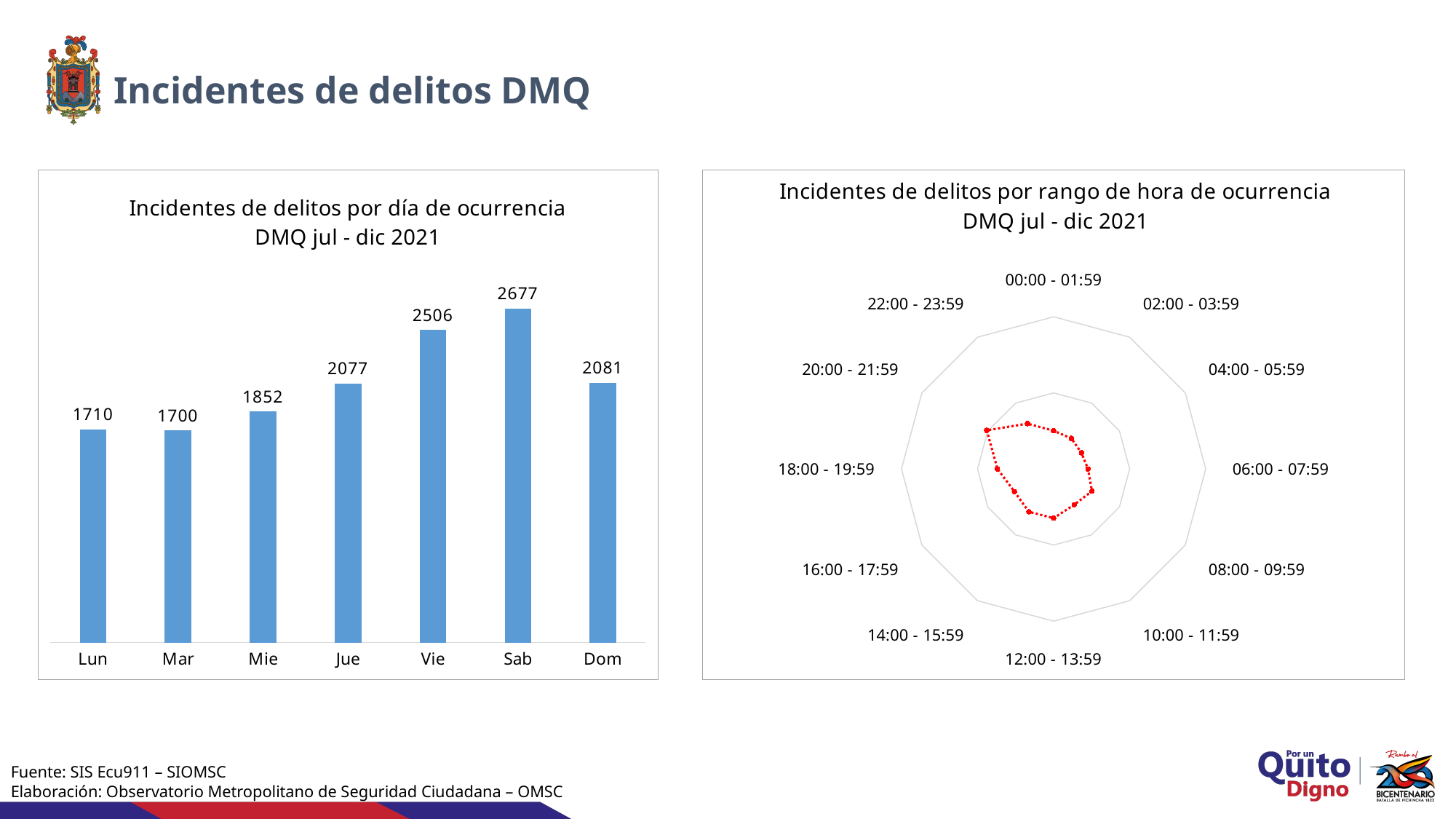
In the chart 'Incidentes de delitos por día de ocurrencia DMQ jul - dic 2021', how many days are shown on the x axis? 7 In the chart 'Incidentes de delitos por día de ocurrencia DMQ jul - dic 2021', what is the value for Sab? 2677 What kind of chart is the left chart, 'Incidentes de delitos por día de ocurrencia DMQ jul - dic 2021'? Bar chart In the chart 'Incidentes de delitos por día de ocurrencia DMQ jul - dic 2021', which day has the lowest value? Mar In the chart 'Incidentes de delitos por día de ocurrencia DMQ jul - dic 2021', which day has the highest value? Sab In the chart 'Incidentes de delitos por día de ocurrencia DMQ jul - dic 2021', what is the difference between the values for Sab and Vie? 171 In the chart 'Incidentes de delitos por día de ocurrencia DMQ jul - dic 2021', what is the value for Mie? 1852 In the chart 'Incidentes de delitos por rango de hora de ocurrencia DMQ jul - dic 2021', which hour range has the highest value? 20:00 - 21:59 In the chart 'Incidentes de delitos por rango de hora de ocurrencia DMQ jul - dic 2021', how many hour ranges are shown? 12 What kind of chart is the right chart, 'Incidentes de delitos por rango de hora de ocurrencia DMQ jul - dic 2021'? Radar chart In the chart 'Incidentes de delitos por día de ocurrencia DMQ jul - dic 2021', which is larger, the value for Jue or the value for Dom? Dom In the chart 'Incidentes de delitos por día de ocurrencia DMQ jul - dic 2021', do the values rise or fall from Mie to Sab? Rise